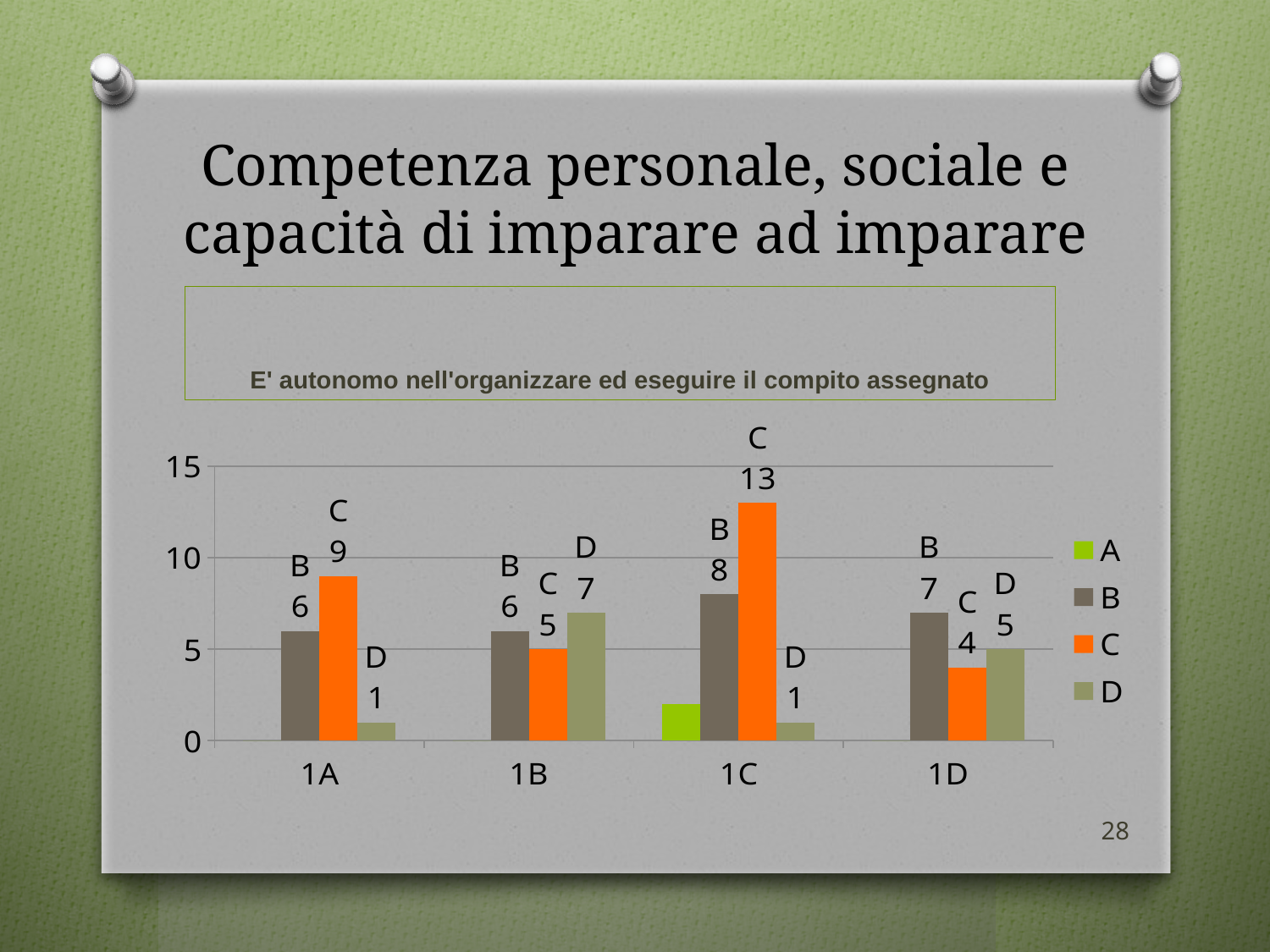
Which is larger in category 1B: the value for series C or the value for series D? D What is the difference between the values for series C and series B in category 1C? 5 How many categories are shown on the x axis? 4 Which category has the highest value for series C? 1C What is the value for series C in category 1C? 13 Which category has the lowest value for series C? 1D Is the value for series A in category 1C greater or less than 5? less What is the value for series B in category 1D? 7 What is the value for series D in category 1B? 7 What kind of chart is shown on the slide? bar chart How many series does the legend list? 4 What is the title of the chart? E' autonomo nell'organizzare ed eseguire il compito assegnato